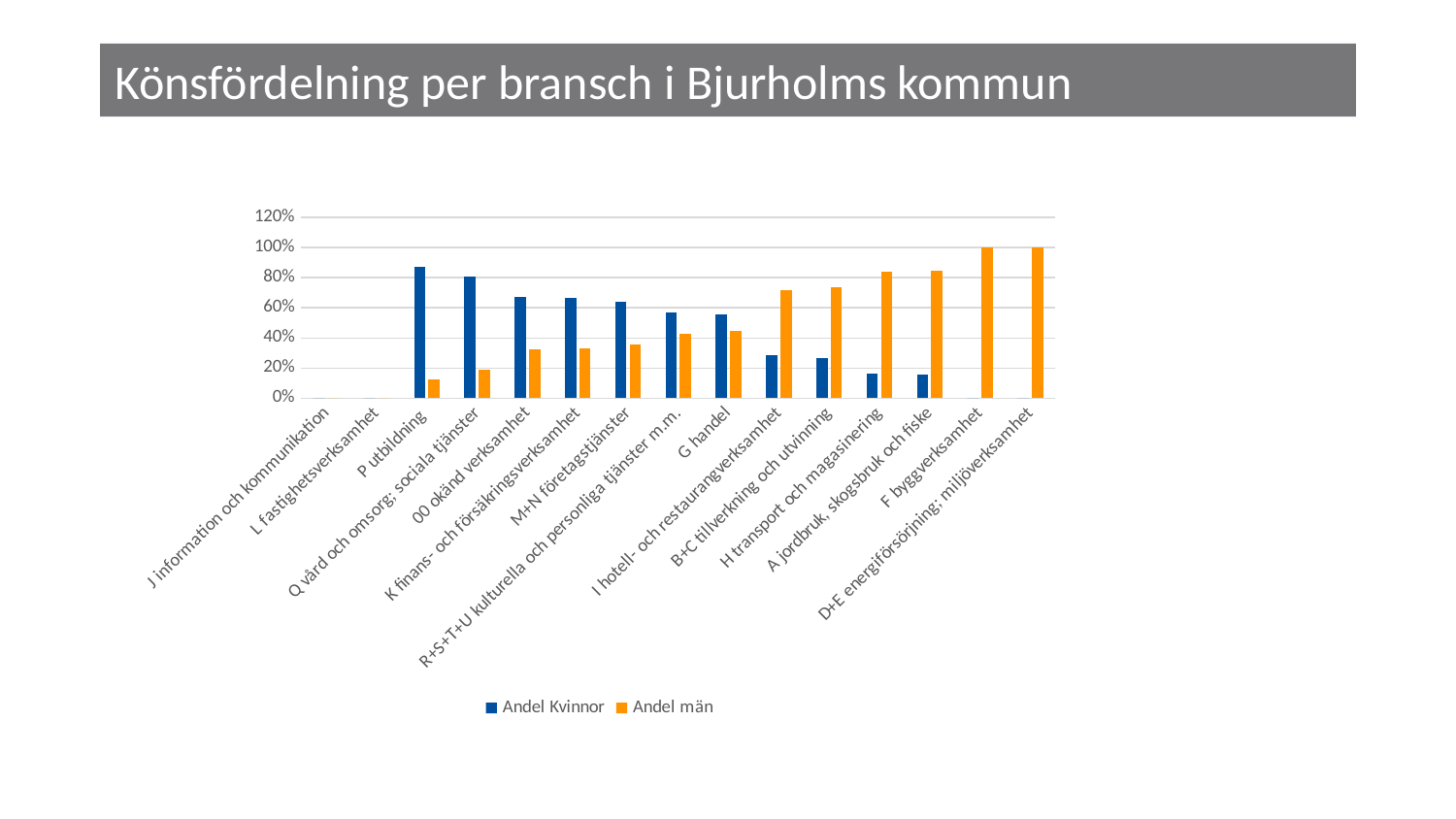
For G handel, which is larger: Andel Kvinnor or Andel män? Andel Kvinnor How many series does the legend list? 2 Do the values for Andel män generally rise or fall from left to right along the x axis? rise How many categories are shown on the x axis? 15 Which colour represents the series Andel män? orange What kind of chart is shown on the slide? bar chart Is the value of Andel Kvinnor for P utbildning greater or less than 80%? greater What is the value of Andel män for D+E energiförsörjning; miljöverksamhet? 100% Is the value of Andel män for P utbildning greater or less than 20%? less Which category has the highest value for Andel Kvinnor? P utbildning What is the value of Andel män for F byggverksamhet? 100% What is the title of the chart? Könsfördelning per bransch i Bjurholms kommun